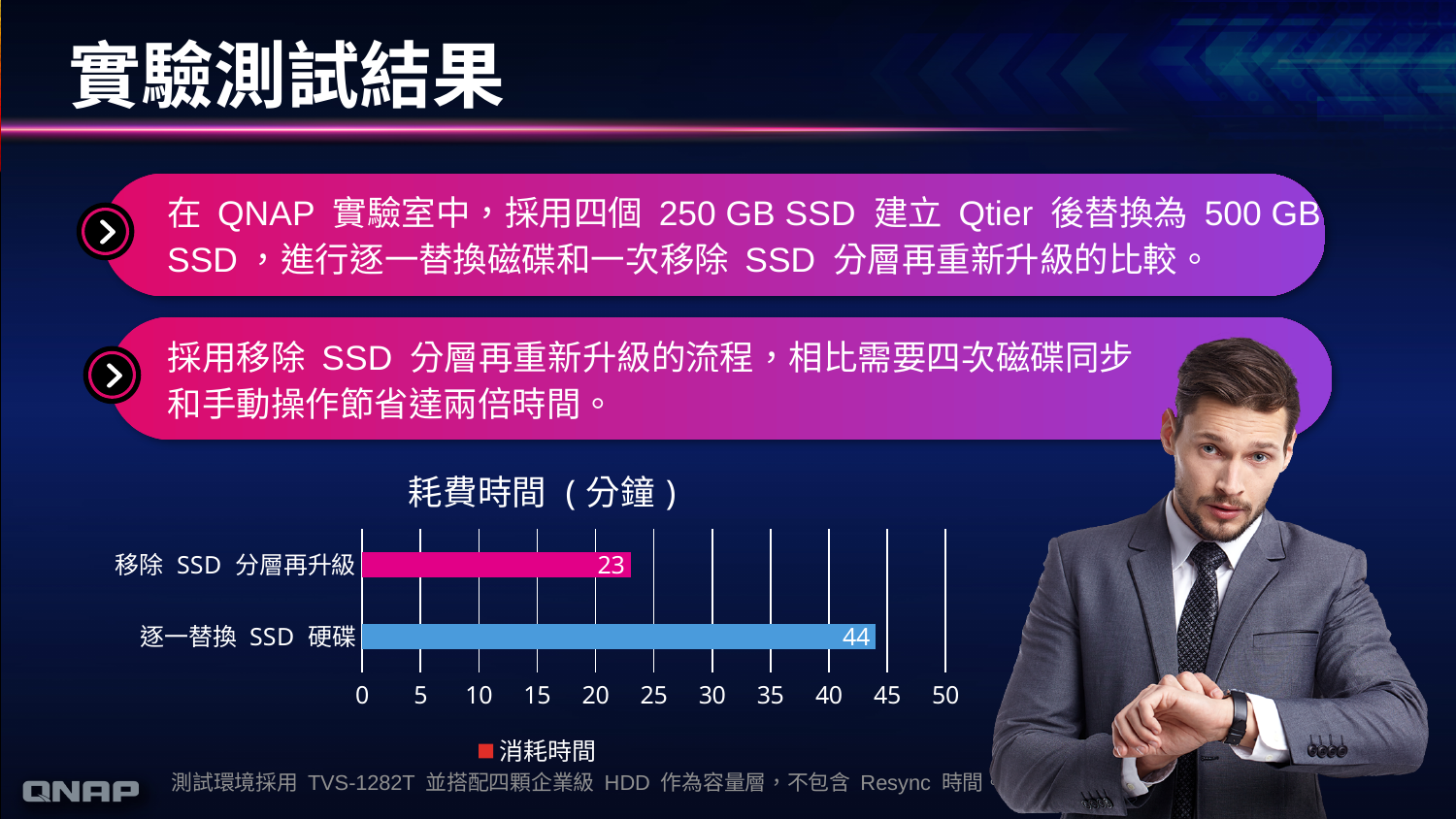
What is the difference between the values for 逐一替換 SSD 硬碟 and 移除 SSD 分層再升級? 21 How many categories are shown in the chart? 2 What kind of chart is shown on the slide? bar chart Which is larger, the value for 移除 SSD 分層再升級 or the value for 逐一替換 SSD 硬碟? 逐一替換 SSD 硬碟 Which category has the highest value? 逐一替換 SSD 硬碟 How many series does the legend list? 1 What is the value for 移除 SSD 分層再升級? 23 What is the title of the chart? 耗費時間（分鐘） What is the value for 逐一替換 SSD 硬碟? 44 Is the value for 逐一替換 SSD 硬碟 greater or less than 40? greater Is the value for 移除 SSD 分層再升級 greater or less than 25? less Which category has the lowest value? 移除 SSD 分層再升級